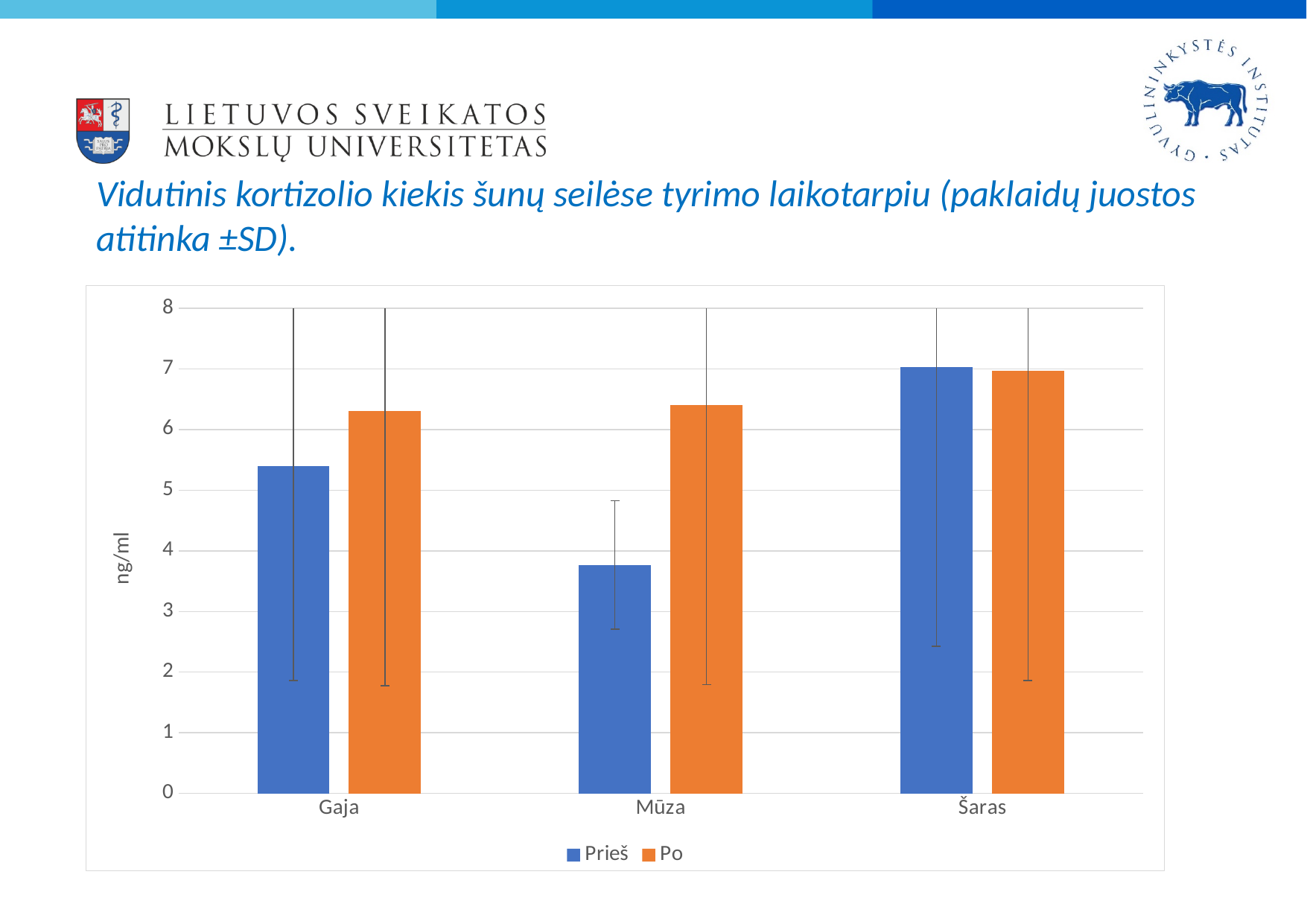
Which dog has the highest Po value? Šaras Is the Prieš value for Mūza greater or less than 4? less For Gaja, which is larger: the Prieš value or the Po value? Po How many dogs (categories) are shown on the x axis? 3 Is the Po value for Mūza greater or less than 6? greater How many series does the legend list? 2 What unit is shown on the y axis? ng/ml Which dog has the highest Prieš value? Šaras For Mūza, which is larger: the Prieš value or the Po value? Po What kind of chart is shown on the slide? bar chart Which dog has the lowest Prieš value? Mūza Is the Prieš value for Gaja greater or less than 5? greater